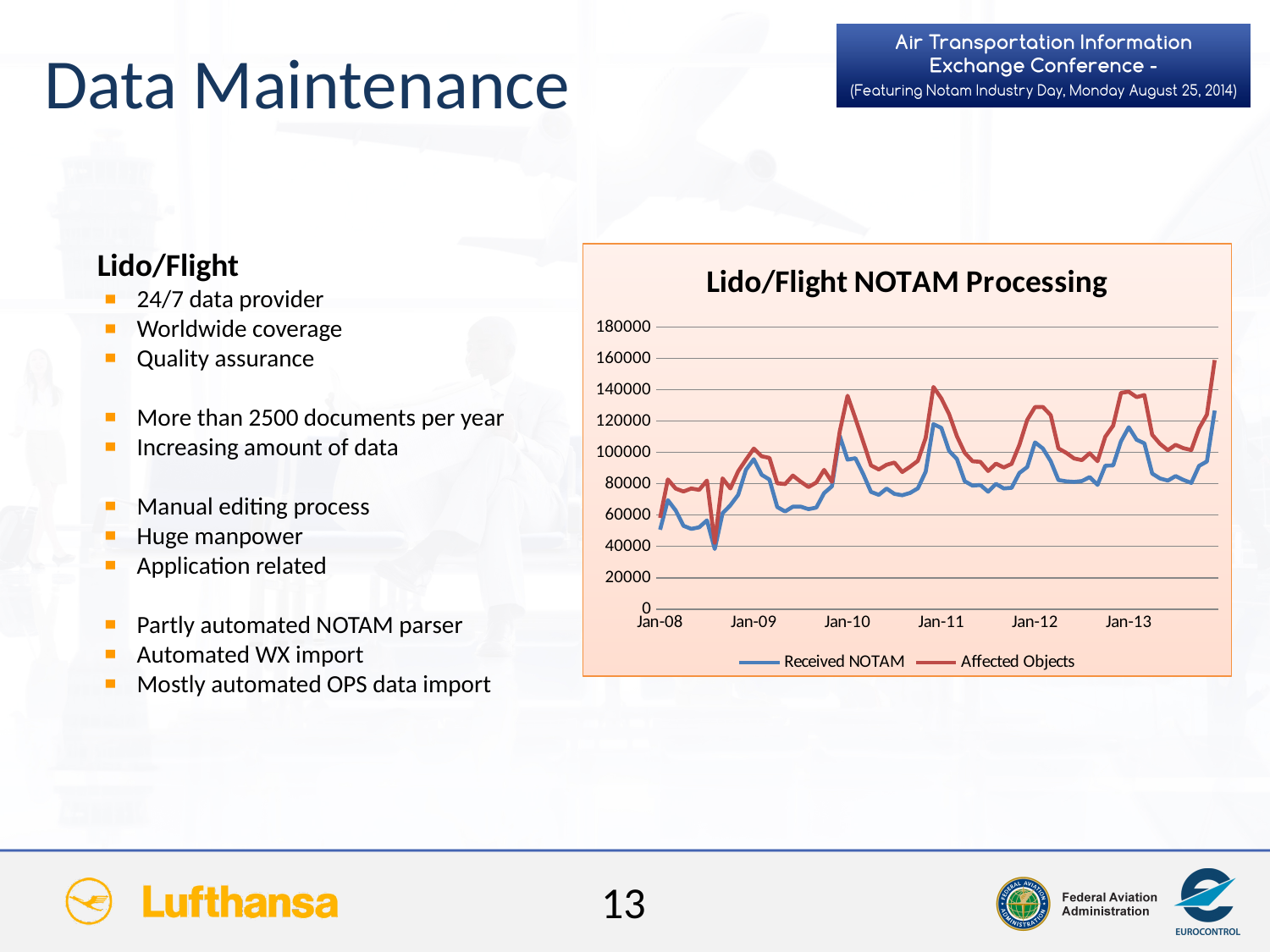
Which two series are listed in the chart's legend? Received NOTAM and Affected Objects Is the highest value for Received NOTAM greater or less than 140000? less What is the maximum value shown on the y axis of the chart? 180000 Is the lowest value for Received NOTAM greater or less than 60000? less Which series is generally plotted above the other across the chart, Received NOTAM or Affected Objects? Affected Objects What is the title of the chart? Lido/Flight NOTAM Processing Is the highest value for Affected Objects greater or less than 140000? greater What kind of chart is shown on the slide? line chart Which series reaches the higher value at the right-hand end of the chart, Received NOTAM or Affected Objects? Affected Objects How many year labels are shown on the x axis of the chart? 6 Do the values for Affected Objects generally rise or fall from Jan-08 to the end of the chart? rise How many series does the chart's legend list? 2